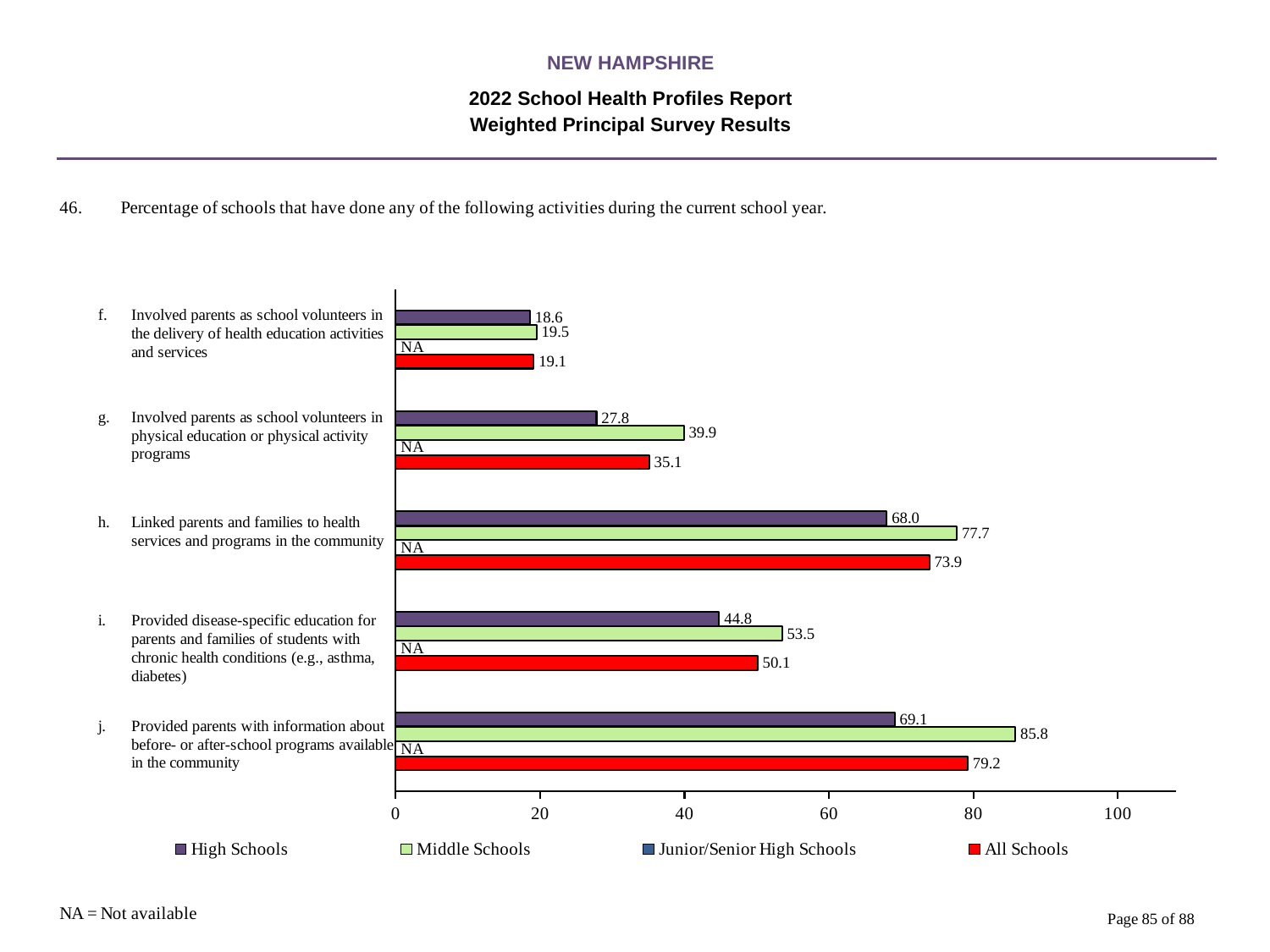
For item i, 'Provided disease-specific education for parents and families of students with chronic health conditions', which is larger: the High Schools value or the Middle Schools value? Middle Schools Which item has the lowest Middle Schools value? f. Involved parents as school volunteers in the delivery of health education activities and services What value is shown for Junior/Senior High Schools for item i, 'Provided disease-specific education for parents and families of students with chronic health conditions'? NA How many series does the legend list? 4 What is the All Schools value for item g, 'Involved parents as school volunteers in physical education or physical activity programs'? 35.1 How many activity items (categories) are plotted on the chart? 5 What kind of chart is shown on the slide? Bar chart What is the difference between the Middle Schools and High Schools values for item g, 'Involved parents as school volunteers in physical education or physical activity programs'? 12.1 Which item has the highest All Schools value? j. Provided parents with information about before- or after-school programs available in the community Is the All Schools value for item h, 'Linked parents and families to health services and programs in the community', greater or less than 60? greater What is the value for High Schools for item h, 'Linked parents and families to health services and programs in the community'? 68.0 What is the value for Middle Schools for item j, 'Provided parents with information about before- or after-school programs available in the community'? 85.8